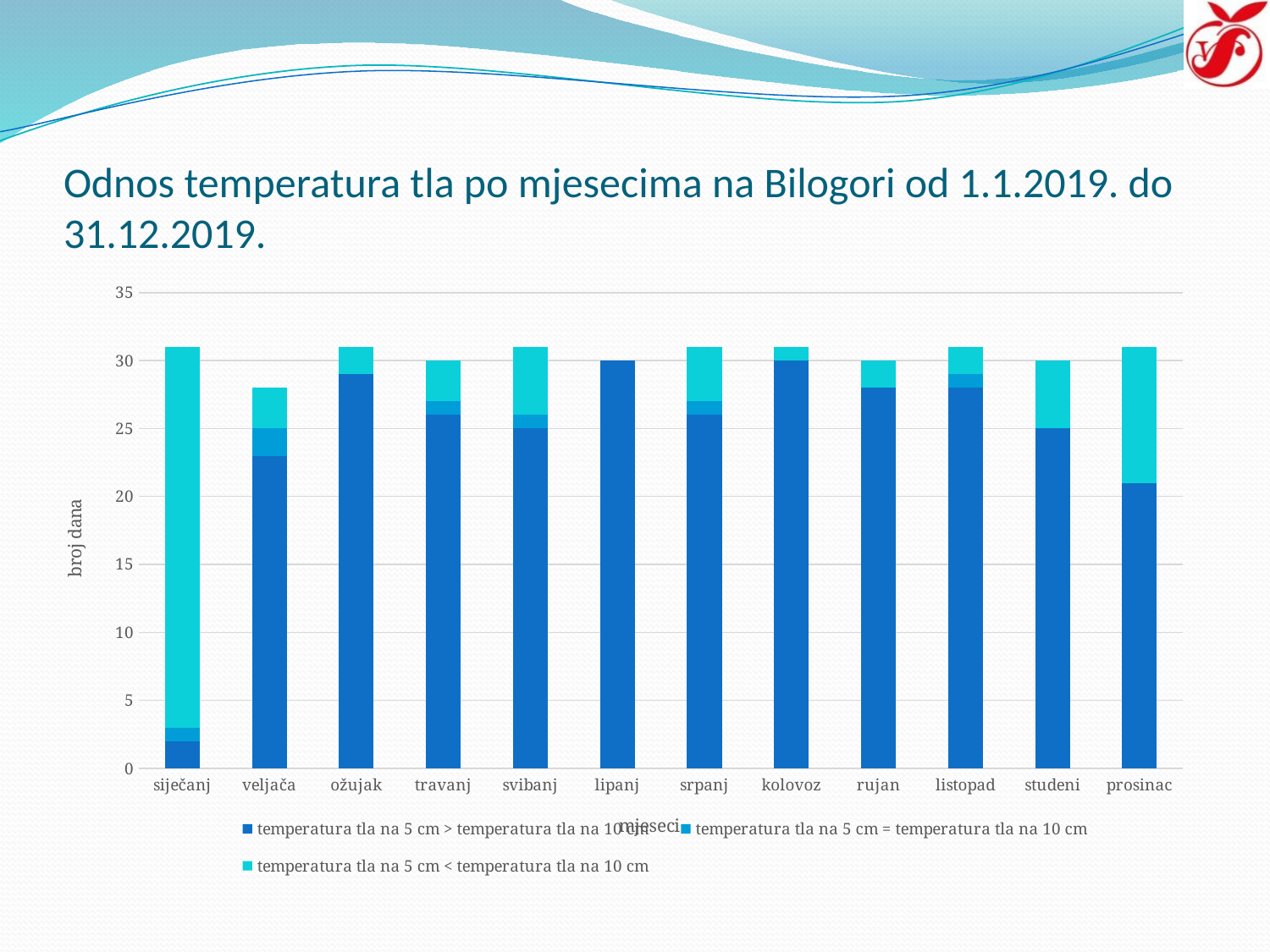
How many series does the legend list? 3 Which month has the smallest segment for 'temperatura tla na 5 cm > temperatura tla na 10 cm'? siječanj Is the total height of the stacked bar for veljača greater or less than 30? less Which month has the largest segment for 'temperatura tla na 5 cm < temperatura tla na 10 cm'? siječanj Is the 'temperatura tla na 5 cm > temperatura tla na 10 cm' value for prosinac greater or less than 25? less Is the 'temperatura tla na 5 cm > temperatura tla na 10 cm' value for siječanj greater or less than 5? less What kind of chart is shown on the slide? stacked bar chart What is the label of the vertical axis? broj dana What is the total height of the stacked bar for lipanj? 30 Which month has the larger 'temperatura tla na 5 cm > temperatura tla na 10 cm' value, ožujak or prosinac? ožujak How many months (categories) are shown on the x axis? 12